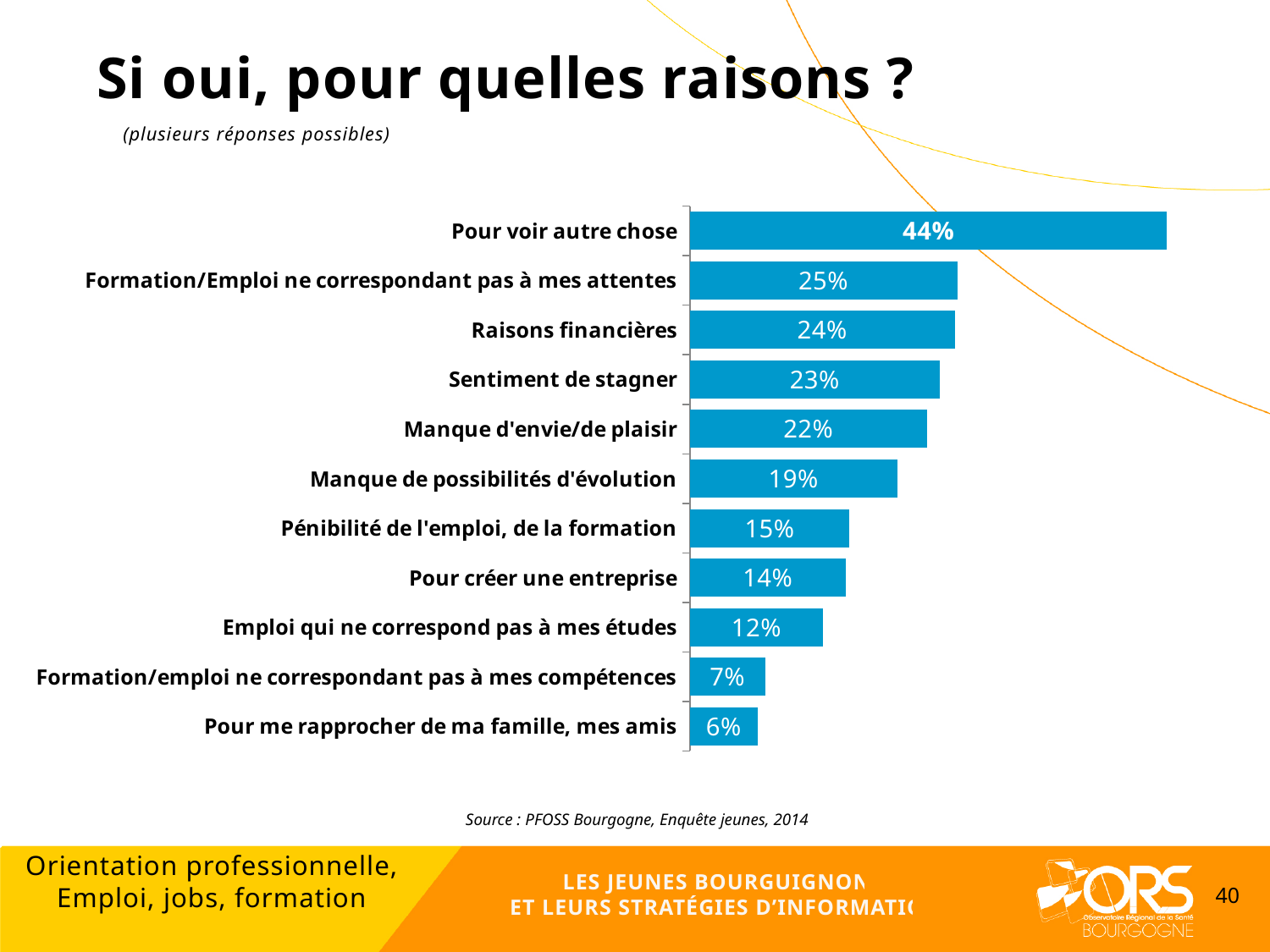
What source is cited below the chart? PFOSS Bourgogne, Enquête jeunes, 2014 What kind of chart is shown on the slide? Bar chart What is the value for "Pour me rapprocher de ma famille, mes amis"? 6% How many reasons (categories) are shown in the chart? 11 What is the value for "Raisons financières"? 24% Which reason has the lowest percentage? Pour me rapprocher de ma famille, mes amis What percentage is shown for "Pour voir autre chose"? 44% Which reason has the highest percentage? Pour voir autre chose What is the difference between "Pour voir autre chose" and "Formation/Emploi ne correspondant pas à mes attentes"? 19 percentage points What percentage is shown for "Pour créer une entreprise"? 14% What is the difference between "Pénibilité de l'emploi, de la formation" and "Formation/emploi ne correspondant pas à mes compétences"? 8 percentage points Which is larger: "Sentiment de stagner" or "Manque de possibilités d'évolution"? Sentiment de stagner